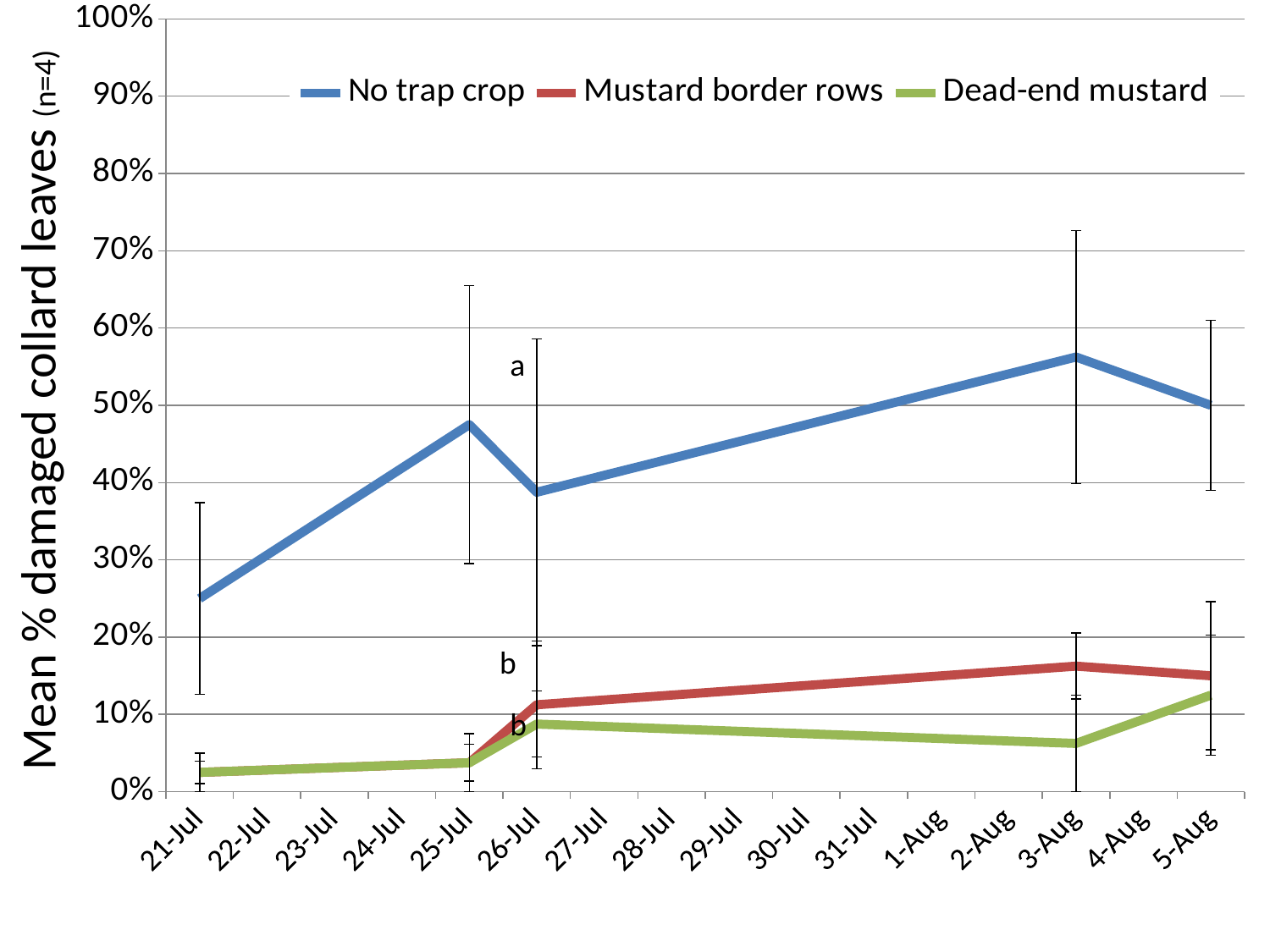
On 5-Aug, which series has the larger value: No trap crop or Mustard border rows? No trap crop Which series has the highest value on 3-Aug? No trap crop Is the value for No trap crop on 25-Jul greater or less than 40%? greater Is the value for No trap crop on 21-Jul greater or less than 30%? less What kind of chart is shown on the slide? line chart Is the value for Mustard border rows on 3-Aug greater or less than 20%? less What is the title of the vertical axis? Mean % damaged collard leaves (n=4) How many series does the legend list? 3 What are the three series named in the legend? No trap crop, Mustard border rows, Dead-end mustard On which date does the No trap crop series reach its highest value? 3-Aug For Dead-end mustard, which date has the larger value: 3-Aug or 5-Aug? 5-Aug